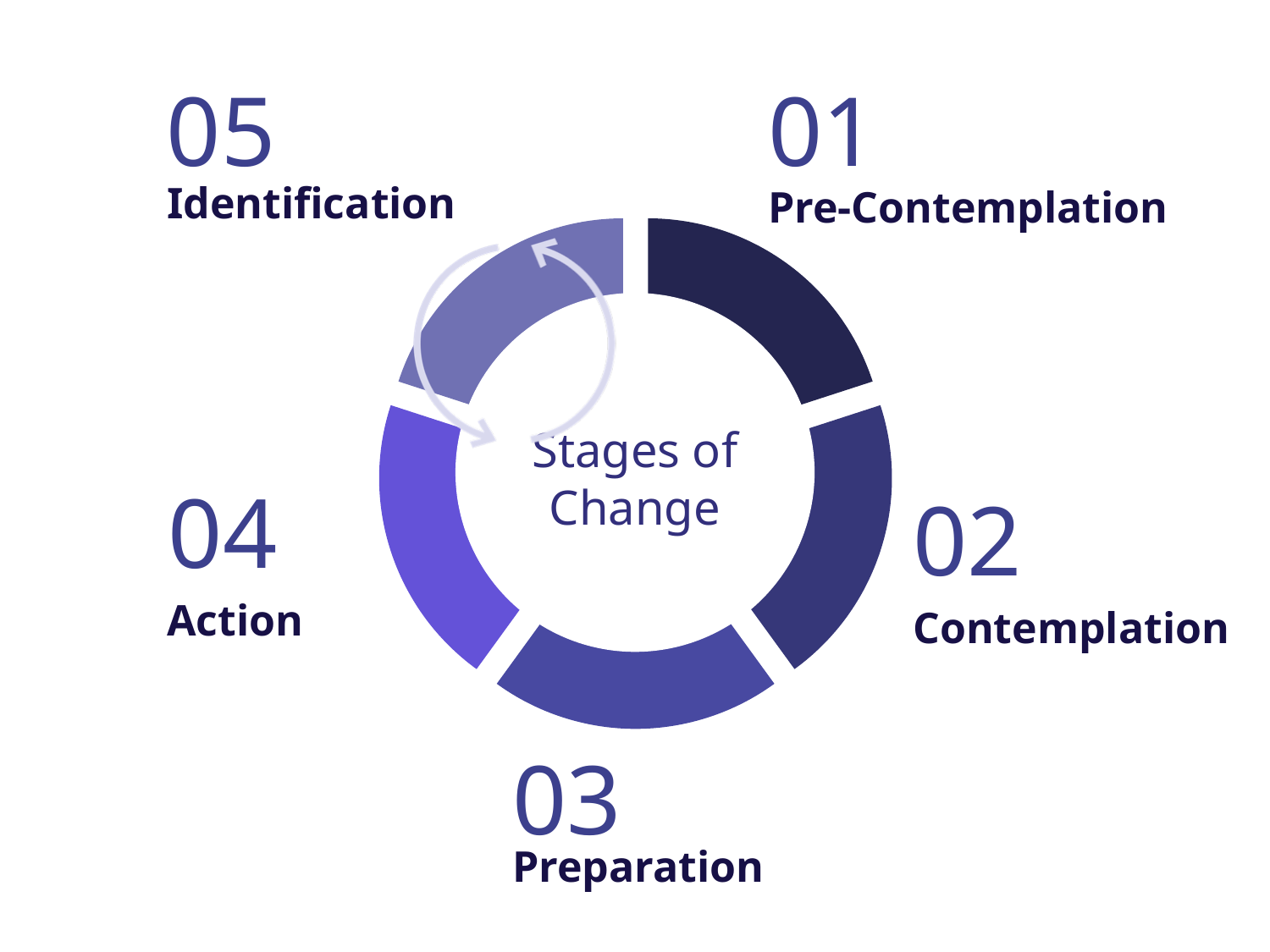
Which stage is labelled 02? Contemplation How many segments does the Stages of Change doughnut chart have? 5 What kind of chart is shown on the slide? Doughnut chart What number is assigned to the Identification stage? 05 What is the title shown in the centre of the doughnut chart? Stages of Change What number is assigned to the Action stage? 04 Which stage is labelled 01? Pre-Contemplation Which stage is labelled 03 on the chart? Preparation Which segment of the doughnut chart is the darkest in colour? Pre-Contemplation